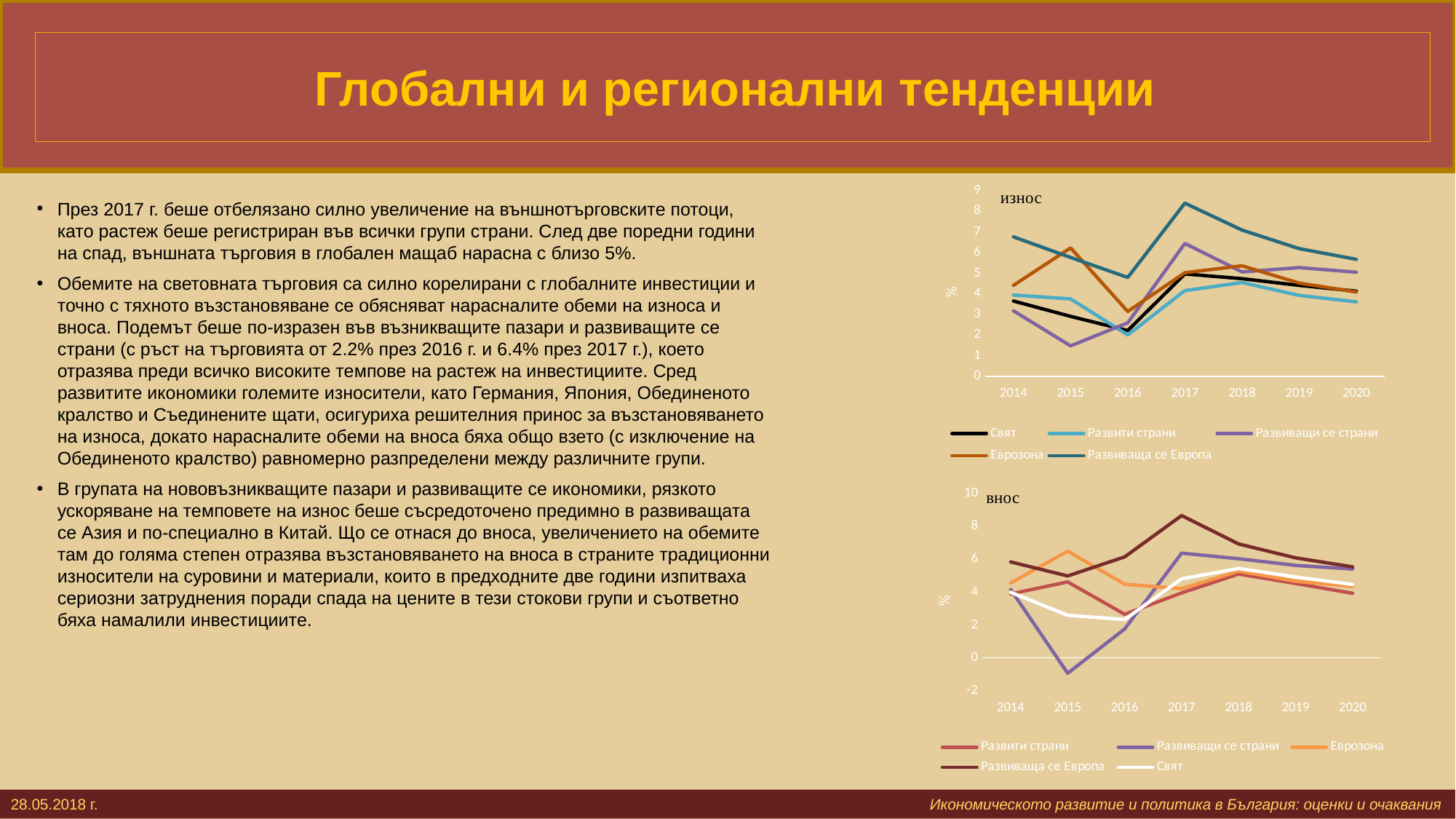
On the "внос" chart, which is larger in 2015: Еврозона or Развити страни? Еврозона On the "износ" chart, is the value for Развиващи се страни in 2015 greater or less than 2? less On the "износ" chart, which series has the lowest value in 2015? Развиващи се страни On the "внос" chart, which series has the highest value in 2017? Развиваща се Европа How many series does the legend of the "внос" chart list? 5 How many years are shown on the x axis of the "износ" chart? 7 What kind of chart is the "износ" chart? line chart On the "износ" chart, which series has the highest value in 2017? Развиваща се Европа On the "износ" chart, is the value for Развиваща се Европа in 2017 greater or less than 8? greater What is the title of the lower chart on the slide? внос On the "внос" chart, is the value for Развиващи се страни in 2015 greater or less than 0? less On the "износ" chart, does the Развиваща се Европа line rise or fall from 2017 to 2020? fall